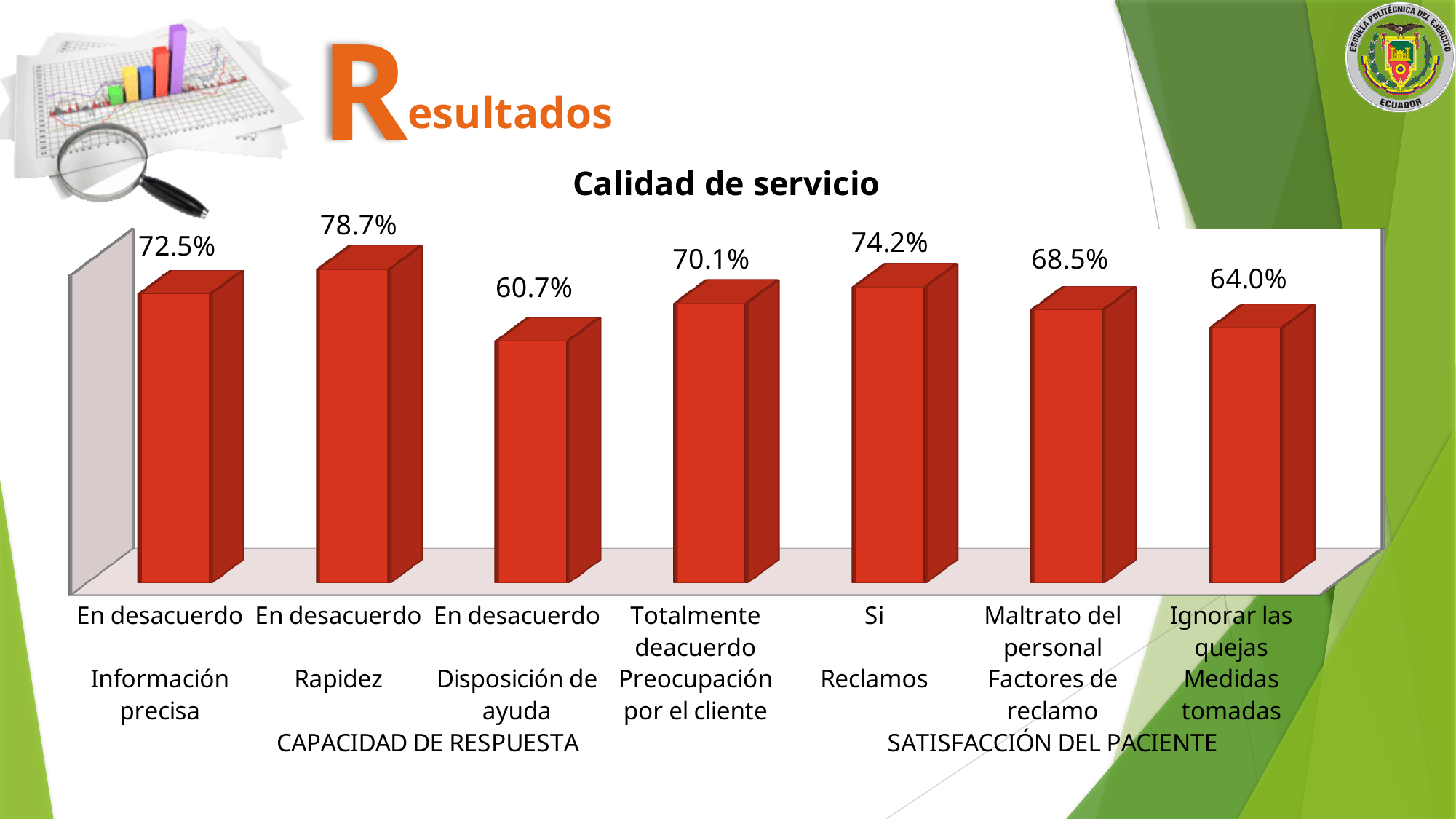
Which is larger, the value for Preocupación por el cliente or the value for Factores de reclamo? Preocupación por el cliente What is the value for Medidas tomadas (Ignorar las quejas)? 64.0% Which category has the highest value? Rapidez What is the difference between the values for Rapidez and Disposición de ayuda? 18.0% What are the two group labels shown beneath the category labels? CAPACIDAD DE RESPUESTA and SATISFACCIÓN DEL PACIENTE What kind of chart is shown on the slide? Bar chart What is the value for Información precisa? 72.5% What is the value for Reclamos (Si)? 74.2% Which category has the lowest value? Disposición de ayuda What is the value for Rapidez in the Calidad de servicio chart? 78.7% How many bars are plotted in the chart? 7 What is the title of the chart? Calidad de servicio